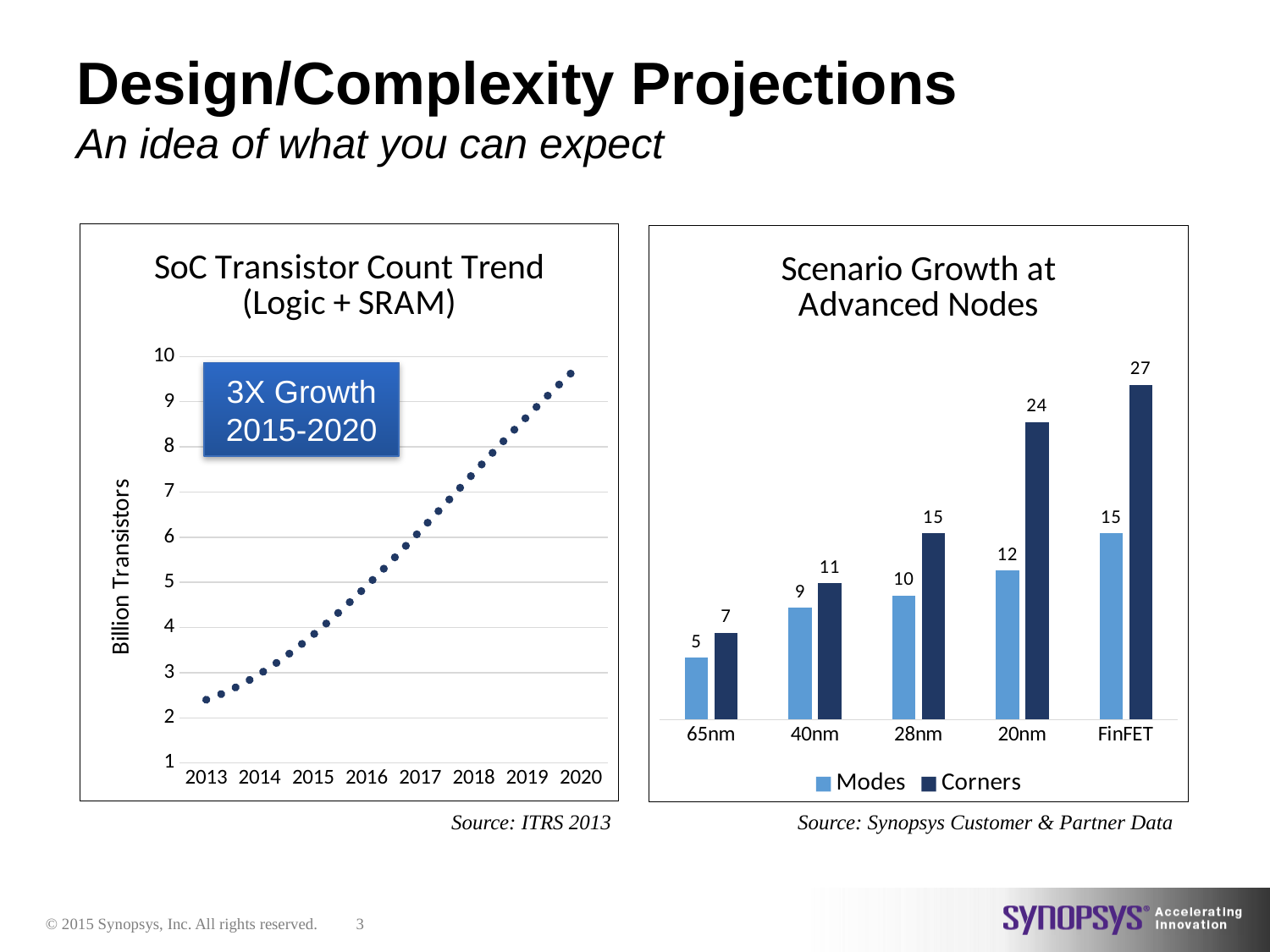
In the Scenario Growth at Advanced Nodes chart, what is the difference between the Corners and Modes values for FinFET? 12 In the SoC Transistor Count Trend chart, is the value for 2013 greater or less than 3 billion transistors? less In the SoC Transistor Count Trend chart, do the values rise or fall from 2013 to 2020? Rise In the Scenario Growth at Advanced Nodes chart, which node has the highest Corners value? FinFET In the Scenario Growth at Advanced Nodes chart, which is larger: the Corners value for 28nm or the Modes value for 20nm? Corners for 28nm What kind of chart is the Scenario Growth at Advanced Nodes chart? Bar chart How many nodes are shown on the x axis of the Scenario Growth at Advanced Nodes chart? 5 In the Scenario Growth at Advanced Nodes chart, what is the Modes value for 40nm? 9 What is the y-axis label of the SoC Transistor Count Trend chart? Billion Transistors How many series does the legend of the Scenario Growth at Advanced Nodes chart list? 2 In the Scenario Growth at Advanced Nodes chart, what is the Corners value for 20nm? 24 In the Scenario Growth at Advanced Nodes chart, which node has the lowest Modes value? 65nm